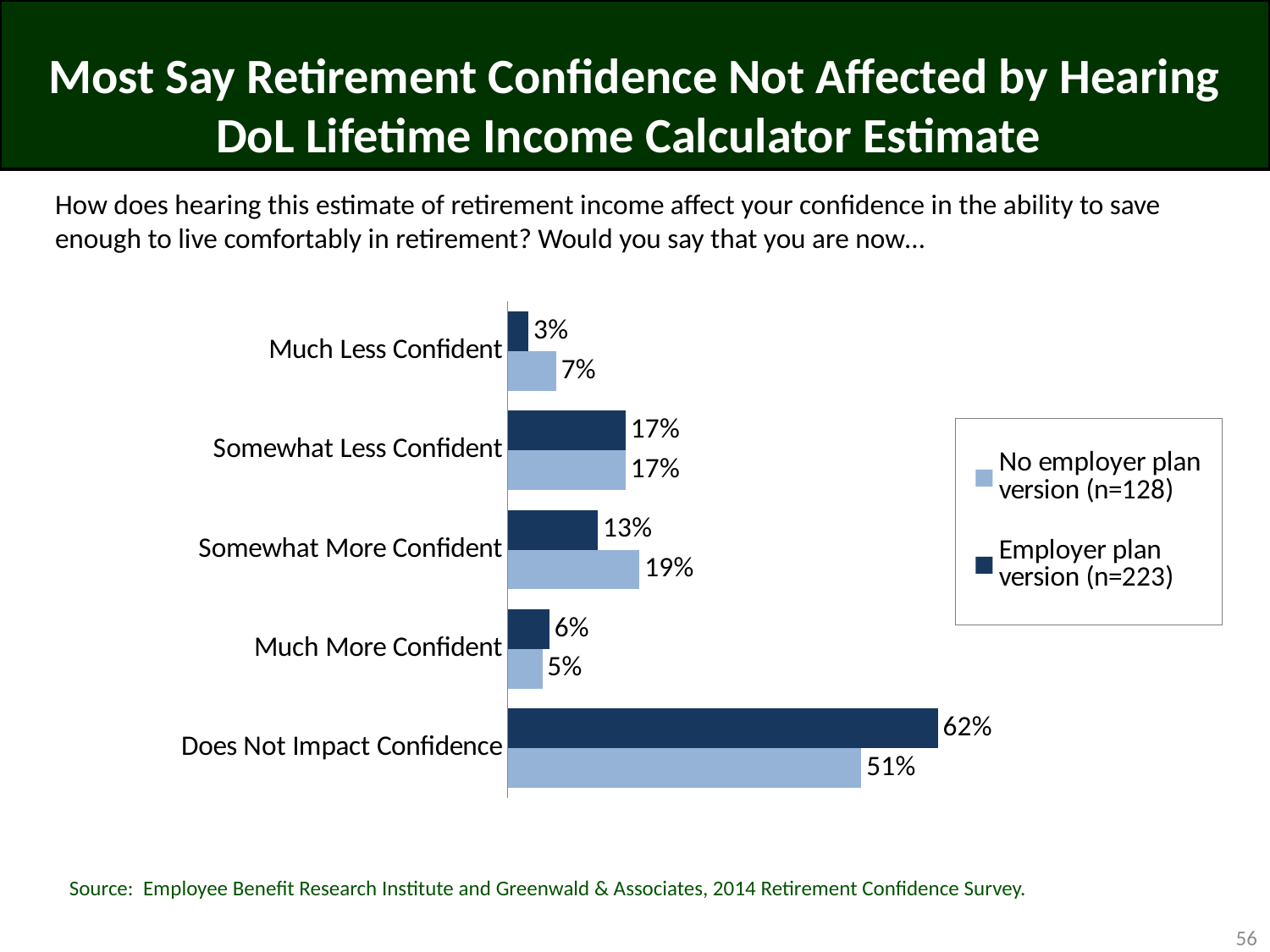
What is the value for Much Less Confident in the Employer plan version series? 3% What is the sample size (n) for the Employer plan version series according to the legend? 223 How many series does the legend list? 2 Which category has the highest value for the No employer plan version series? Does Not Impact Confidence How many response categories are shown on the chart? 5 For Somewhat More Confident, which series has the larger value: Employer plan version or No employer plan version? No employer plan version What type of chart is shown on the slide? Bar chart What is the difference between the Employer plan version and No employer plan version values for Does Not Impact Confidence? 11 percentage points Which series is shown in the darker blue colour? Employer plan version (n=223) Which category has the lowest value for the Employer plan version series? Much Less Confident What percentage of the Employer plan version respondents said hearing the estimate Does Not Impact Confidence? 62% What percentage of the No employer plan version respondents said they are now Somewhat More Confident? 19%